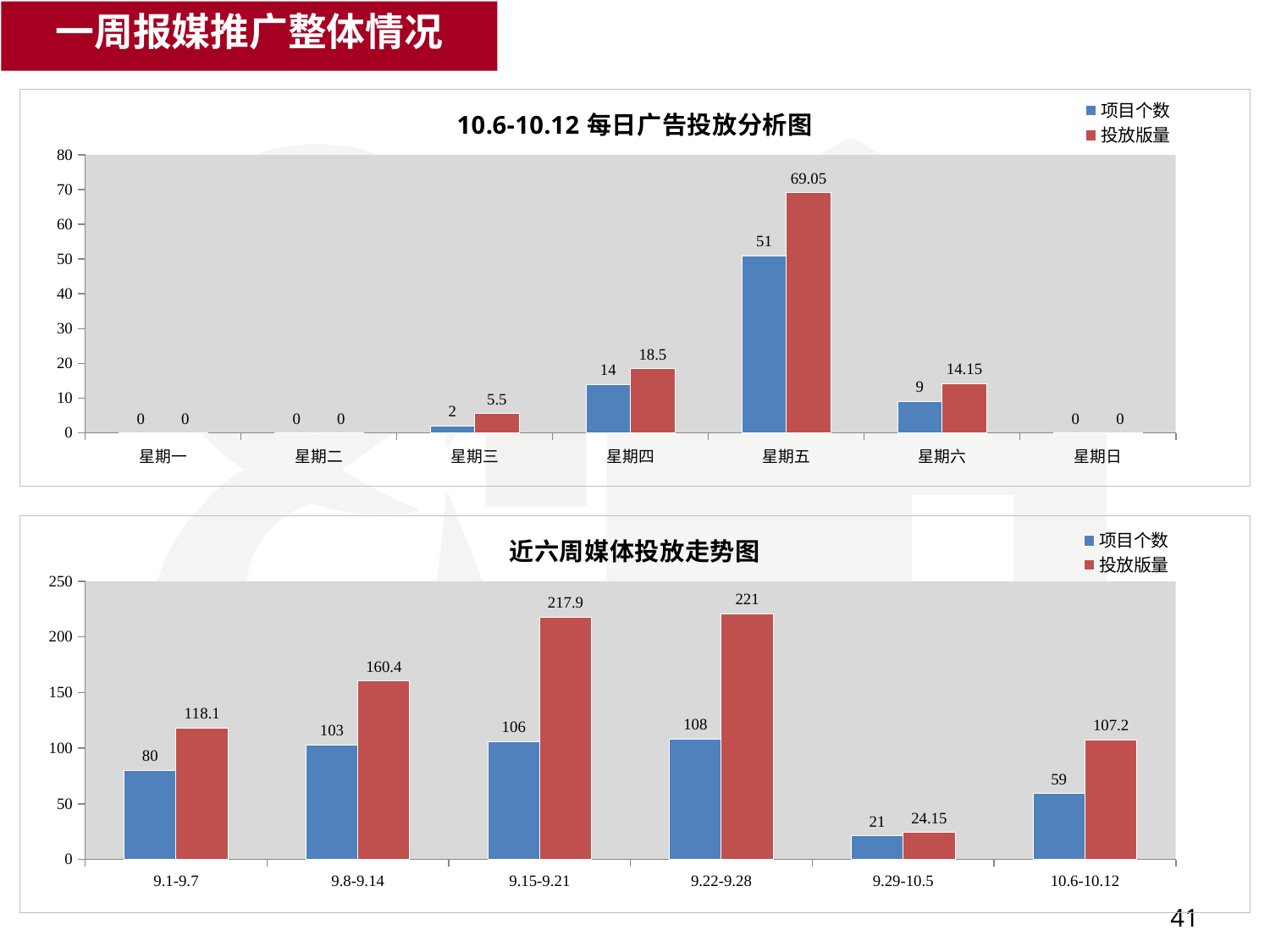
In the top chart (10.6-10.12 每日广告投放分析图), what is the 项目个数 value for 星期四? 14 In the top chart (10.6-10.12 每日广告投放分析图), what is the 投放版量 value for 星期五? 69.05 In the bottom chart (近六周媒体投放走势图), what is the difference between the 项目个数 values for 9.22-9.28 and 9.29-10.5? 87 In the top chart (10.6-10.12 每日广告投放分析图), what is the difference between the 投放版量 values for 星期五 and 星期六? 54.9 In the top chart (10.6-10.12 每日广告投放分析图), which day has the highest 项目个数? 星期五 In the bottom chart (近六周媒体投放走势图), which week has the highest 投放版量? 9.22-9.28 In the bottom chart (近六周媒体投放走势图), which is larger, the 项目个数 for 9.1-9.7 or for 10.6-10.12? 9.1-9.7 In the bottom chart (近六周媒体投放走势图), what is the 投放版量 value for 9.15-9.21? 217.9 In the bottom chart (近六周媒体投放走势图), which week has the lowest 项目个数? 9.29-10.5 In the top chart (10.6-10.12 每日广告投放分析图), how many series does the legend list? 2 What type of chart is the bottom chart (近六周媒体投放走势图)? Bar chart In the top chart (10.6-10.12 每日广告投放分析图), how many days are shown on the x axis? 7